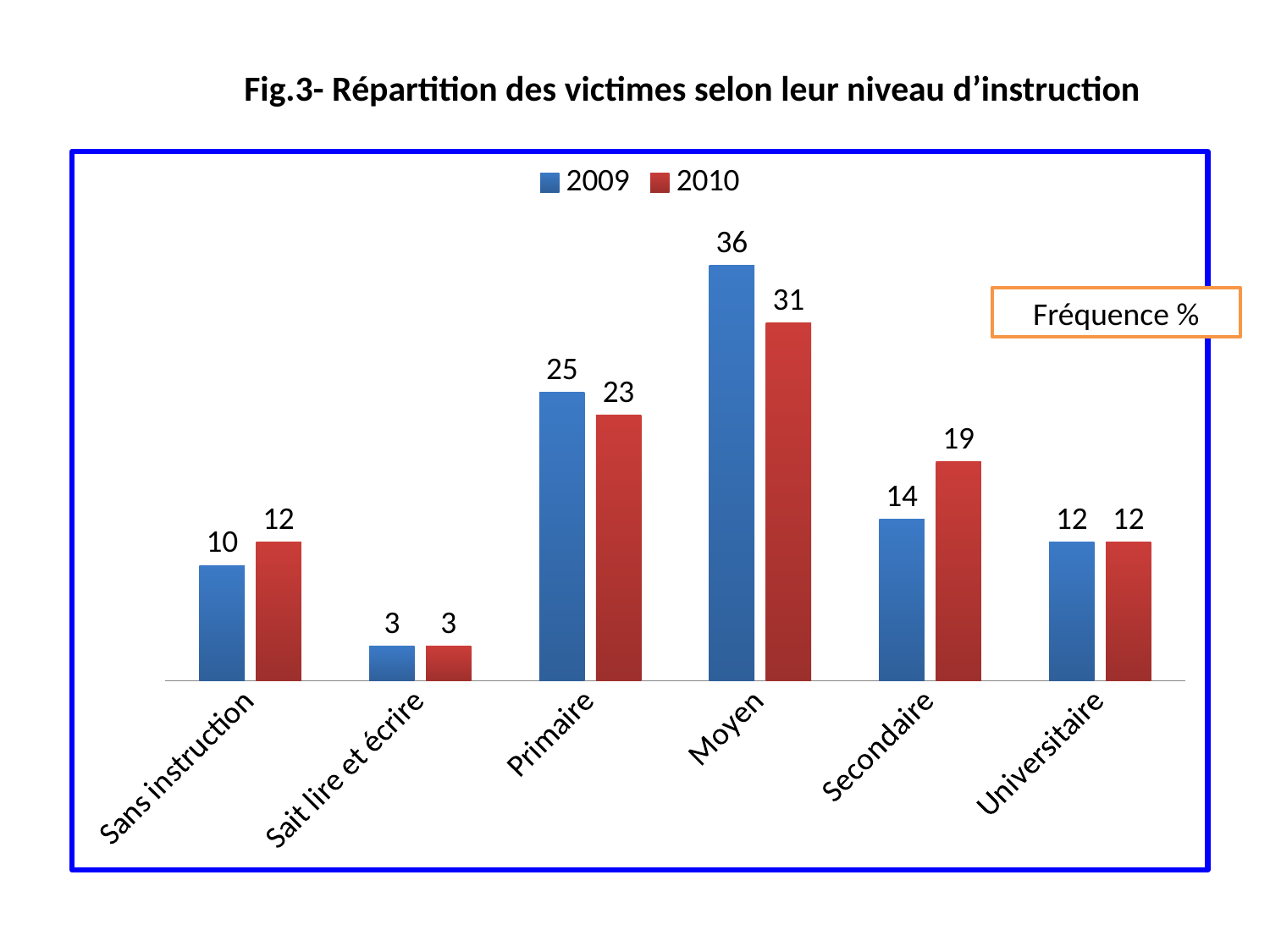
How many categories are shown on the x axis? 6 What is the difference between the 2009 and 2010 values for Secondaire? 5 What is the value for Sans instruction in 2010? 12 What is the value for Moyen in 2009? 36 Which category has the lowest value in 2009? Sait lire et écrire Which category has the highest value in 2010? Moyen What is the title of the chart? Fig.3- Répartition des victimes selon leur niveau d'instruction What kind of chart is shown? Bar chart Which is larger for Primaire: the 2009 value or the 2010 value? 2009 What is the difference between the 2009 and 2010 values for Moyen? 5 What is the value for Secondaire in 2010? 19 How many series does the legend list? 2